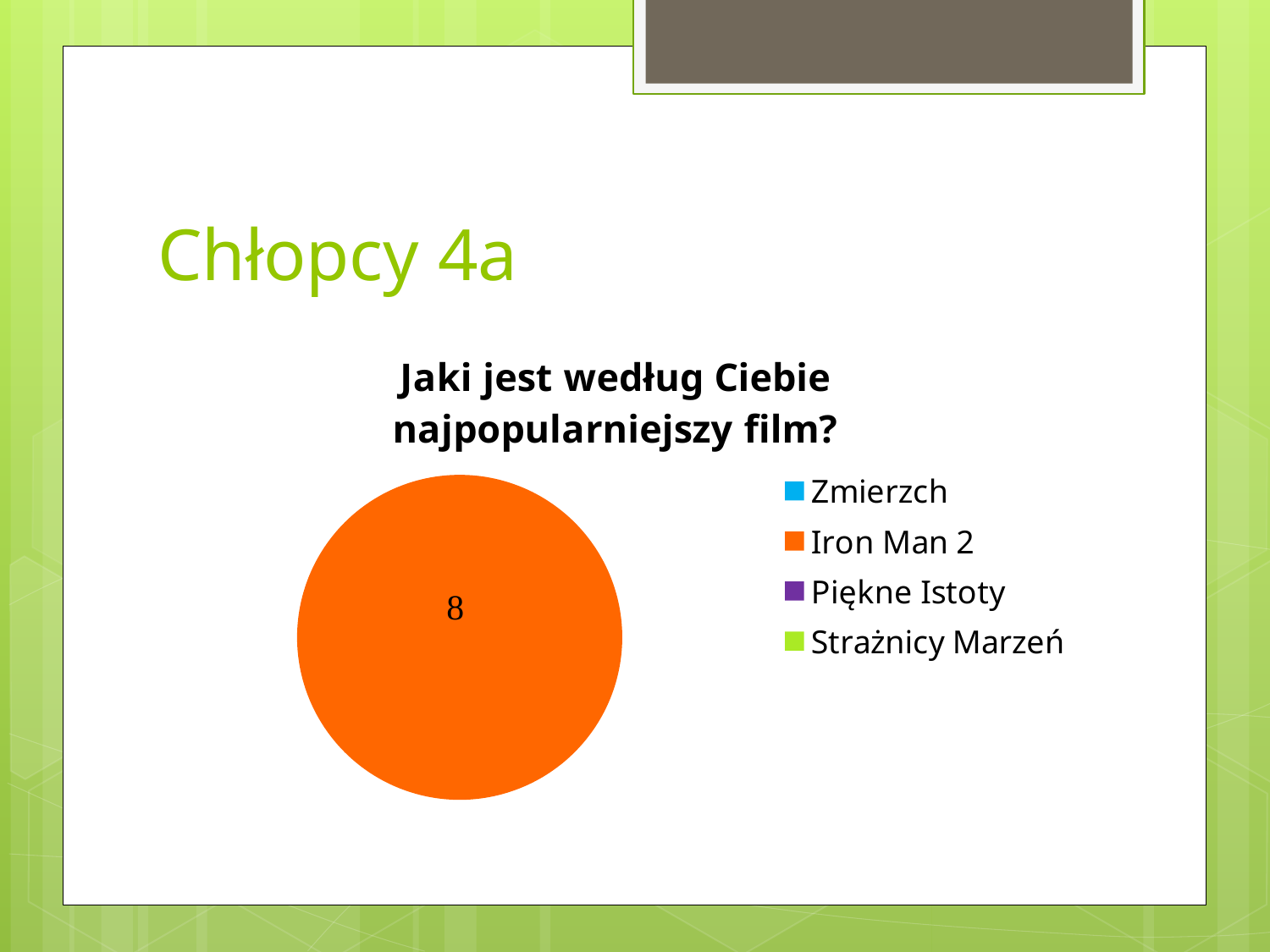
What kind of chart is shown on the slide? pie chart What colour is the Iron Man 2 slice in the pie chart? orange What value is printed on the Iron Man 2 slice of the pie? 8 What is the title of the chart? Jaki jest według Ciebie najpopularniejszy film? How many slices are visible in the pie? 1 What share of the pie does the Iron Man 2 slice take up? 100% How many entries does the chart's legend list? 4 Which film has the largest slice of the pie? Iron Man 2 Which legend entry corresponds to the only visible slice of the pie? Iron Man 2